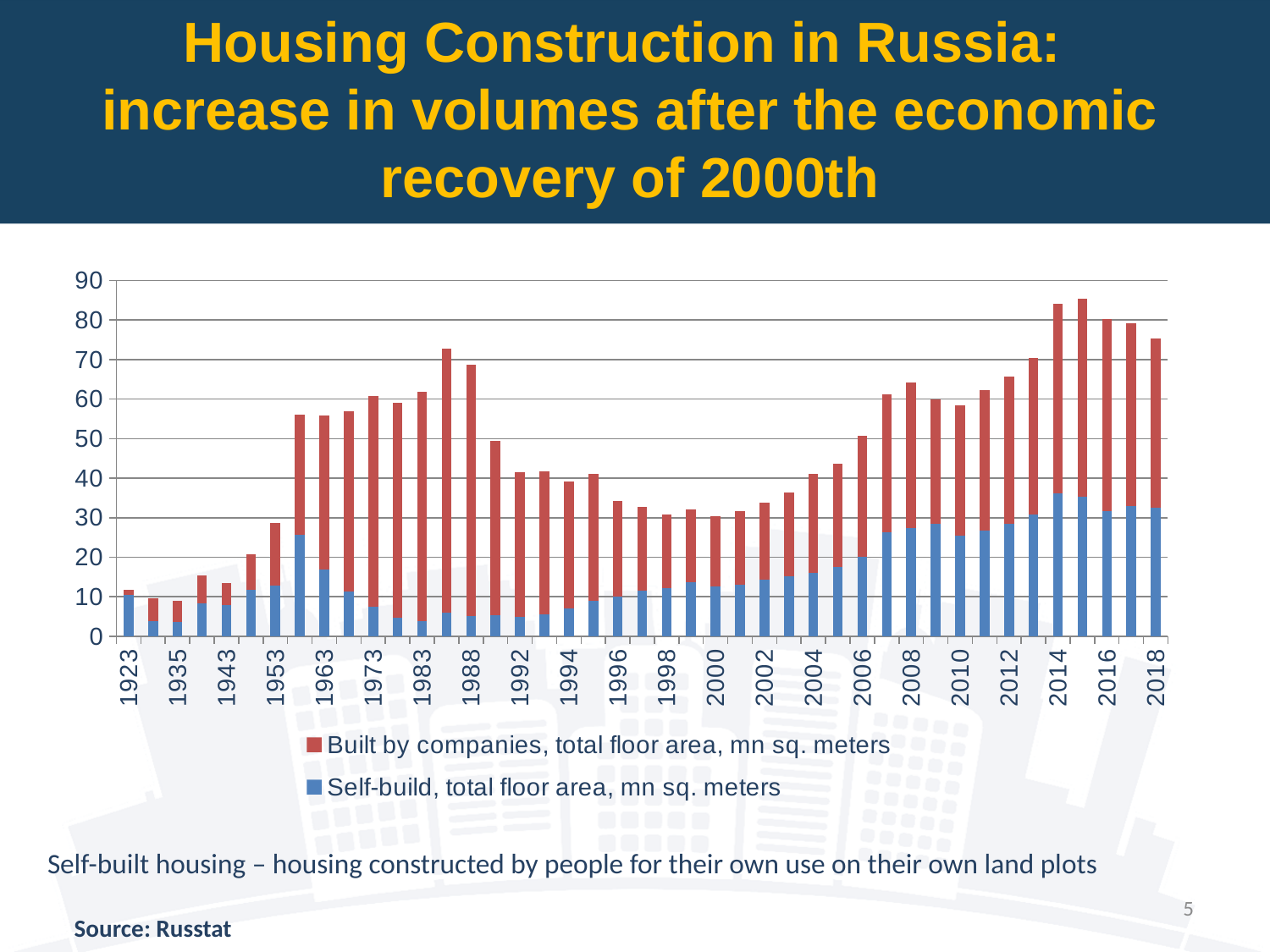
Which year has the larger total floor area, 2018 or 2000? 2018 Is the total floor area for 2018 greater or less than 70? greater Is the total floor area for 2014 greater or less than 80? greater Which series is shown in red? Built by companies, total floor area, mn sq. meters Do the total bars rise or fall from 2000 to 2014? Rise Is the total floor area for 1983 greater or less than 60? greater Which year has the larger self-build floor area, 2014 or 1923? 2014 How many series does the legend list? 2 Which series is shown in blue? Self-build, total floor area, mn sq. meters What kind of chart is shown on the slide? Stacked bar chart